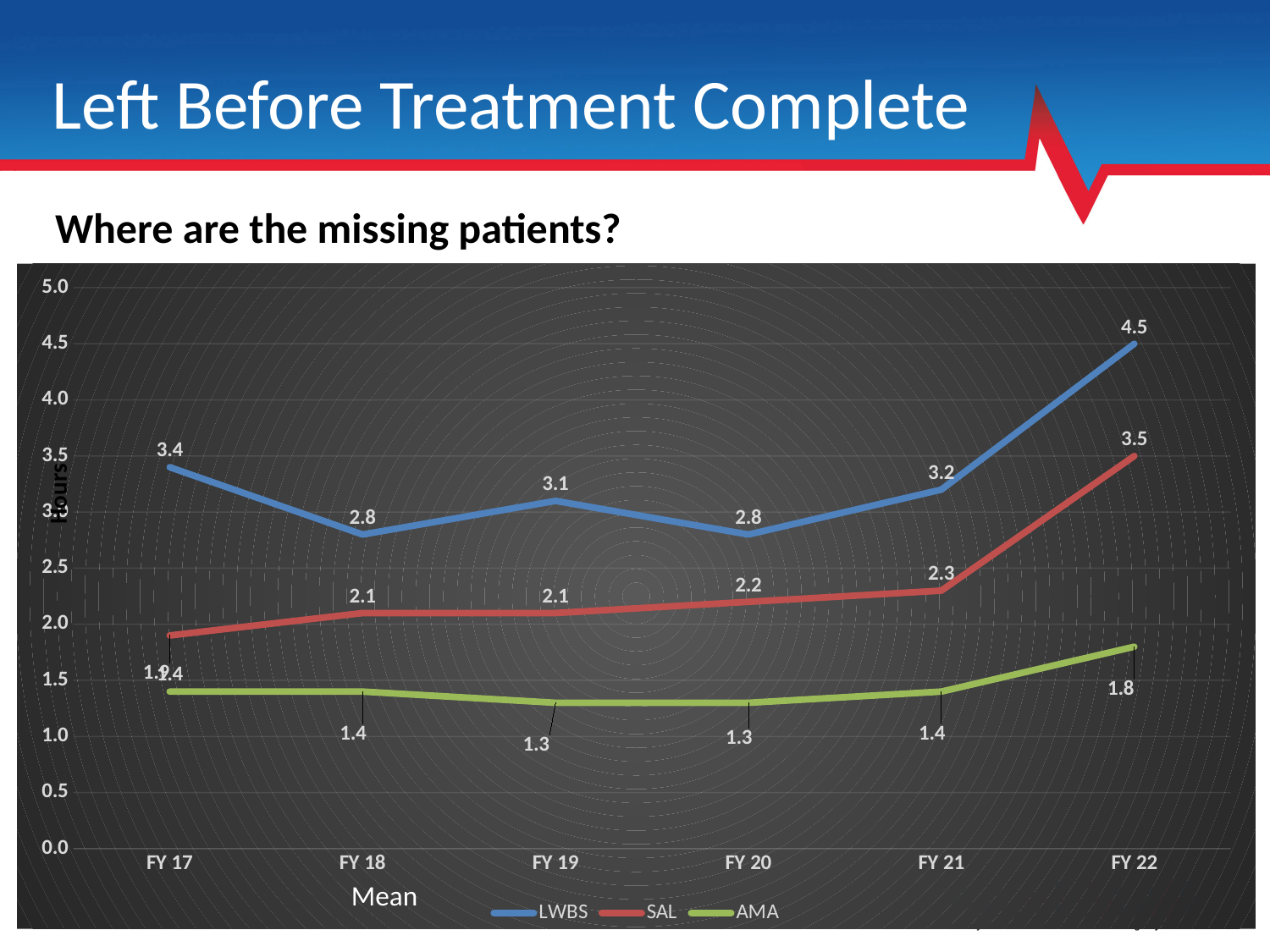
What is the SAL value for FY 21? 2.3 Does the LWBS series rise or fall from FY 20 to FY 22? rise Which series has the larger value in FY 22, LWBS or SAL? LWBS In which fiscal year is the SAL value lowest? FY 17 How many fiscal years are shown on the x axis? 6 Is the LWBS value for FY 18 greater or less than 3.0? less How many series does the legend list? 3 What is the difference between the LWBS values for FY 22 and FY 21? 1.3 In which fiscal year is the LWBS value highest? FY 22 What is the AMA value for FY 19? 1.3 What is the LWBS value for FY 22? 4.5 What kind of chart is shown on the slide? line chart